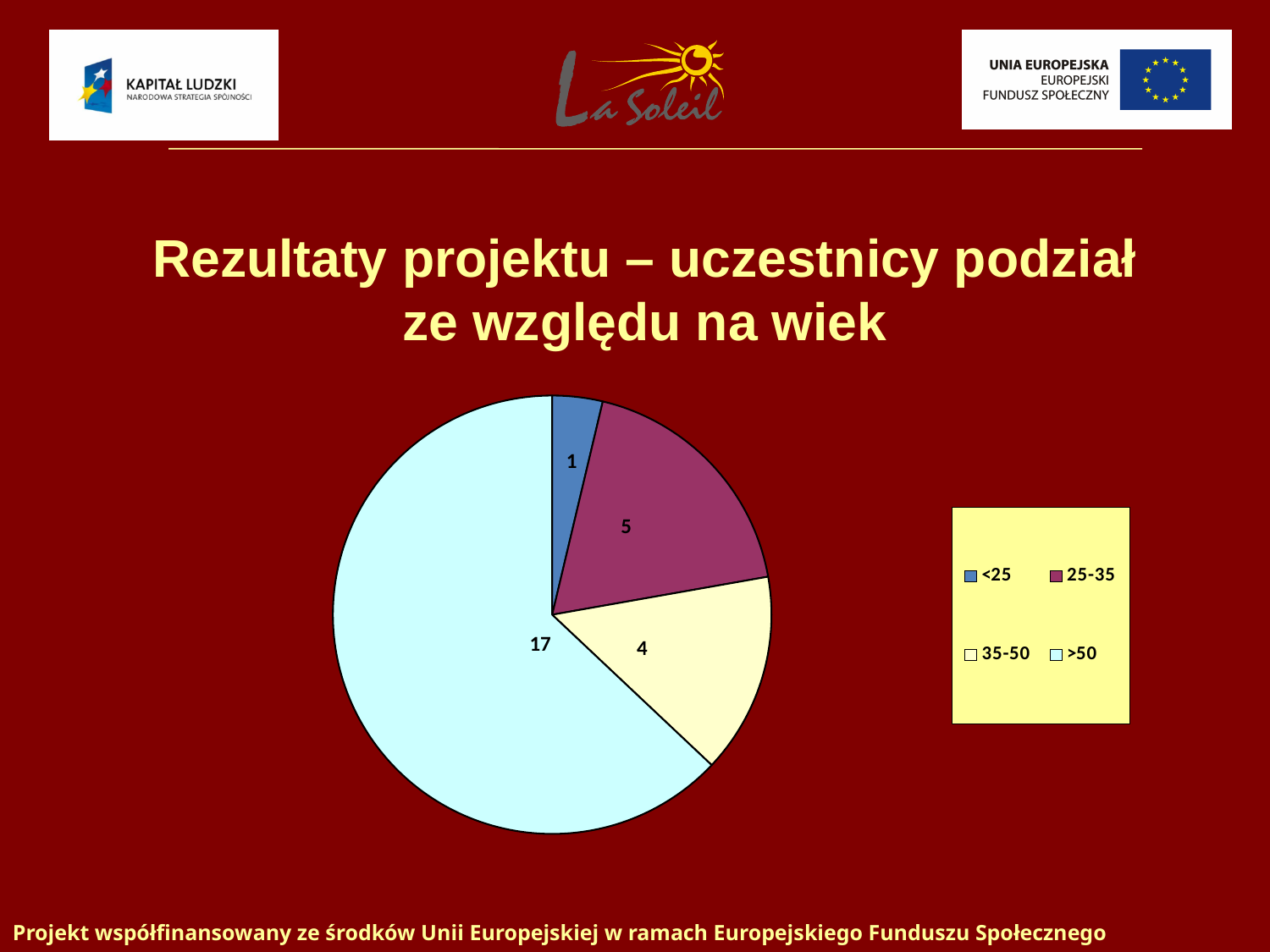
How many participants are in the 25-35 age group? 5 How many participants are in the >50 age group? 17 How many age groups are shown in the pie chart? 4 How many participants are in the <25 age group? 1 What is the total number of participants across all slices of the pie? 27 What type of chart is shown on the slide? pie chart What is the difference between the >50 group and the 25-35 group? 12 Which is larger, the 25-35 group or the 35-50 group? 25-35 What colour is the slice for the 25-35 age group? dark magenta Which age group has the largest slice of the pie? >50 How many participants are in the 35-50 age group? 4 Which age group has the smallest slice of the pie? <25